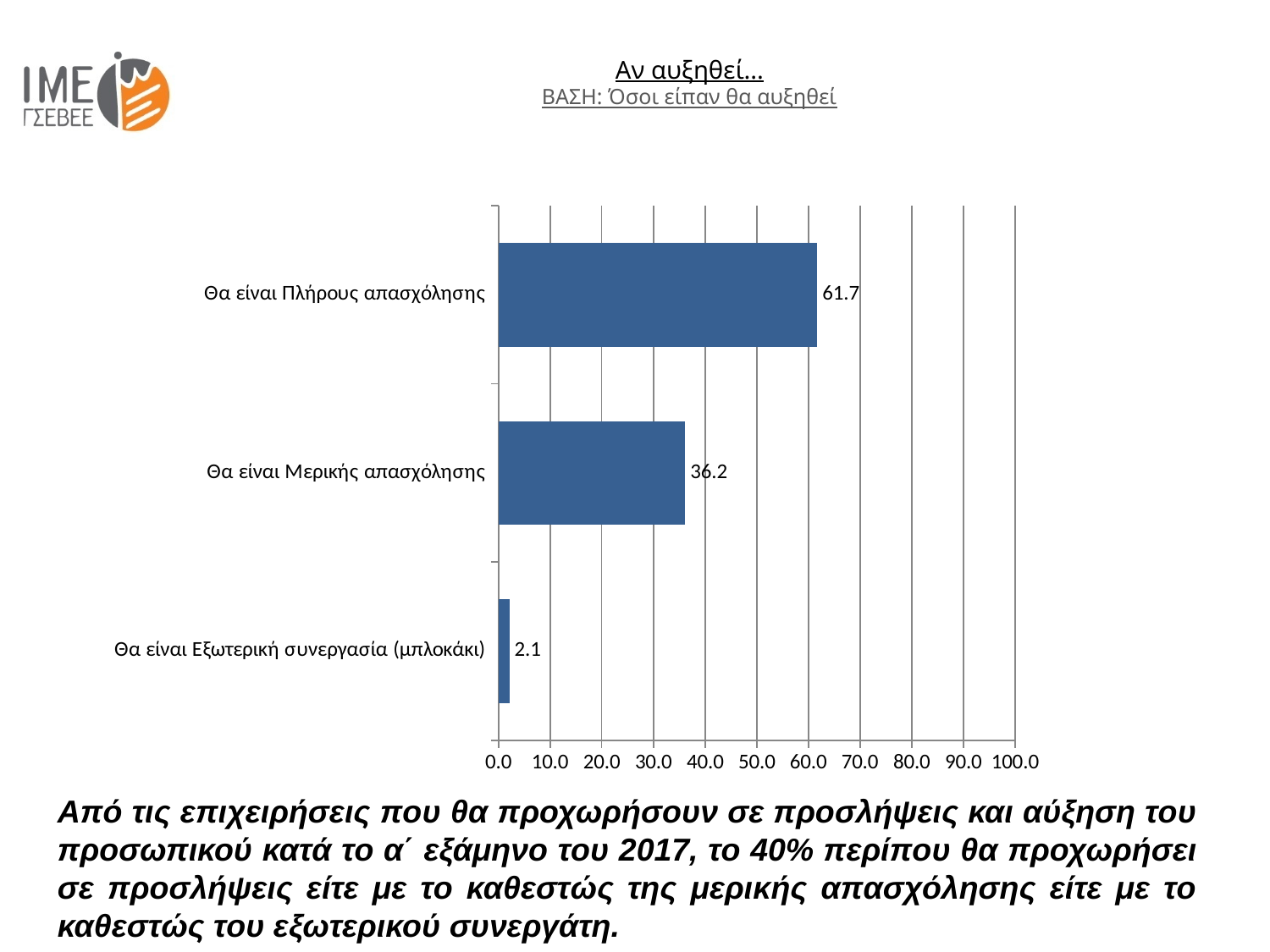
What kind of chart is shown on the slide? bar chart Which is larger: the value for 'Θα είναι Μερικής απασχόλησης' or for 'Θα είναι Εξωτερική συνεργασία (μπλοκάκι)'? Θα είναι Μερικής απασχόλησης What is the value for 'Θα είναι Εξωτερική συνεργασία (μπλοκάκι)'? 2.1 What is the difference between the values for 'Θα είναι Πλήρους απασχόλησης' and 'Θα είναι Μερικής απασχόλησης'? 25.5 What is the title of the chart? Αν αυξηθεί… Is the value for 'Θα είναι Πλήρους απασχόλησης' greater or less than 50.0? greater Which category has the lowest value? Θα είναι Εξωτερική συνεργασία (μπλοκάκι) Which category has the highest value? Θα είναι Πλήρους απασχόλησης How many categories are shown in the chart? 3 What is the difference between the values for 'Θα είναι Μερικής απασχόλησης' and 'Θα είναι Εξωτερική συνεργασία (μπλοκάκι)'? 34.1 What is the value for 'Θα είναι Μερικής απασχόλησης'? 36.2 What is the value for 'Θα είναι Πλήρους απασχόλησης'? 61.7